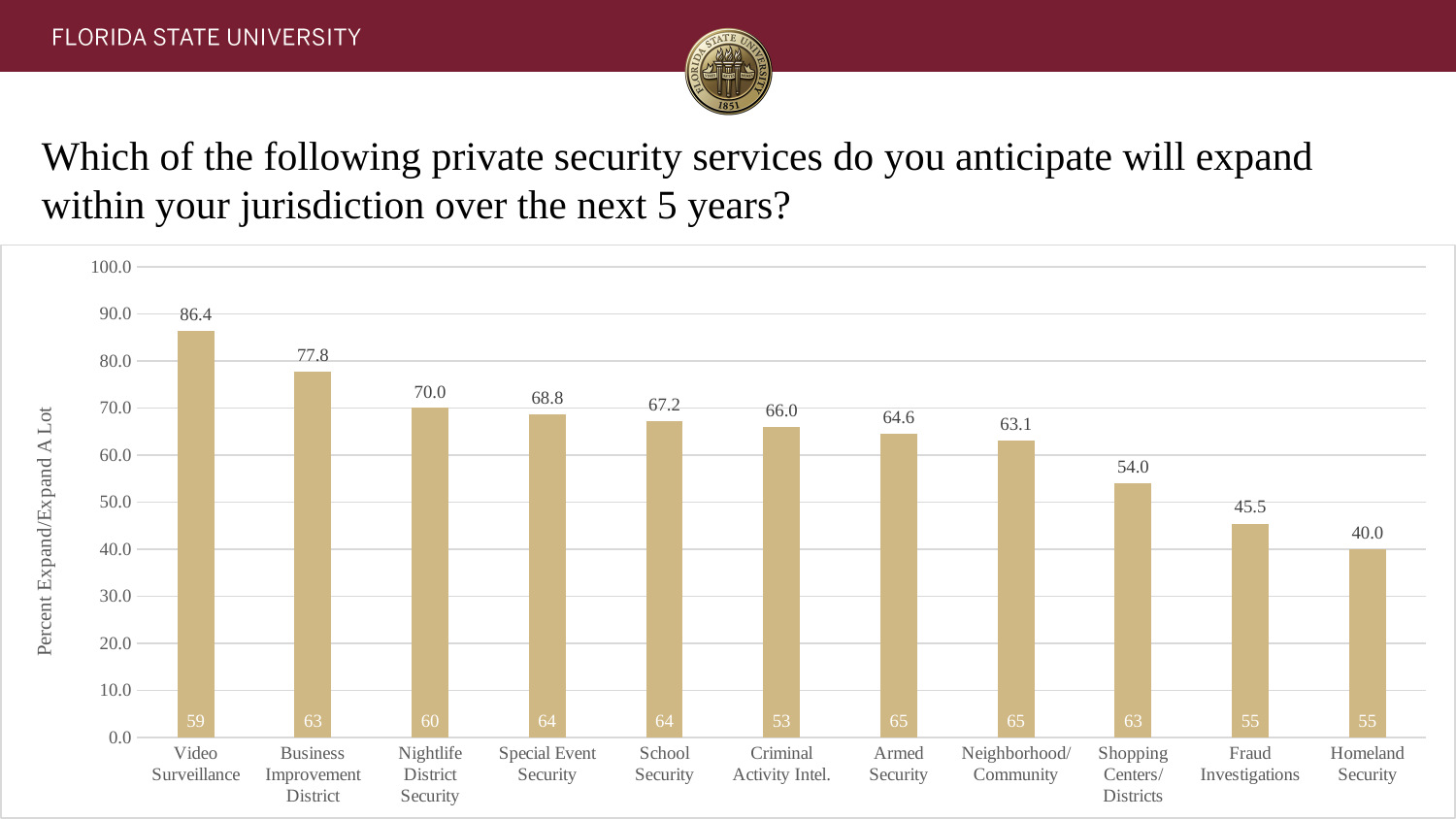
How many categories are shown on the x axis? 11 What kind of chart is this? Bar chart What is the value for Video Surveillance? 86.4 What is the difference between the values for Nightlife District Security and Homeland Security? 30.0 What is the y-axis label? Percent Expand/Expand A Lot What is the value for Armed Security? 64.6 Which is larger, the value for Fraud Investigations or the value for Shopping Centers/Districts? Shopping Centers/Districts What is the difference between the values for Video Surveillance and Business Improvement District? 8.6 Do the values rise or fall from left to right along the x axis? Fall Which category has the highest value? Video Surveillance Which category has the lowest value? Homeland Security What is the value for Shopping Centers/Districts? 54.0